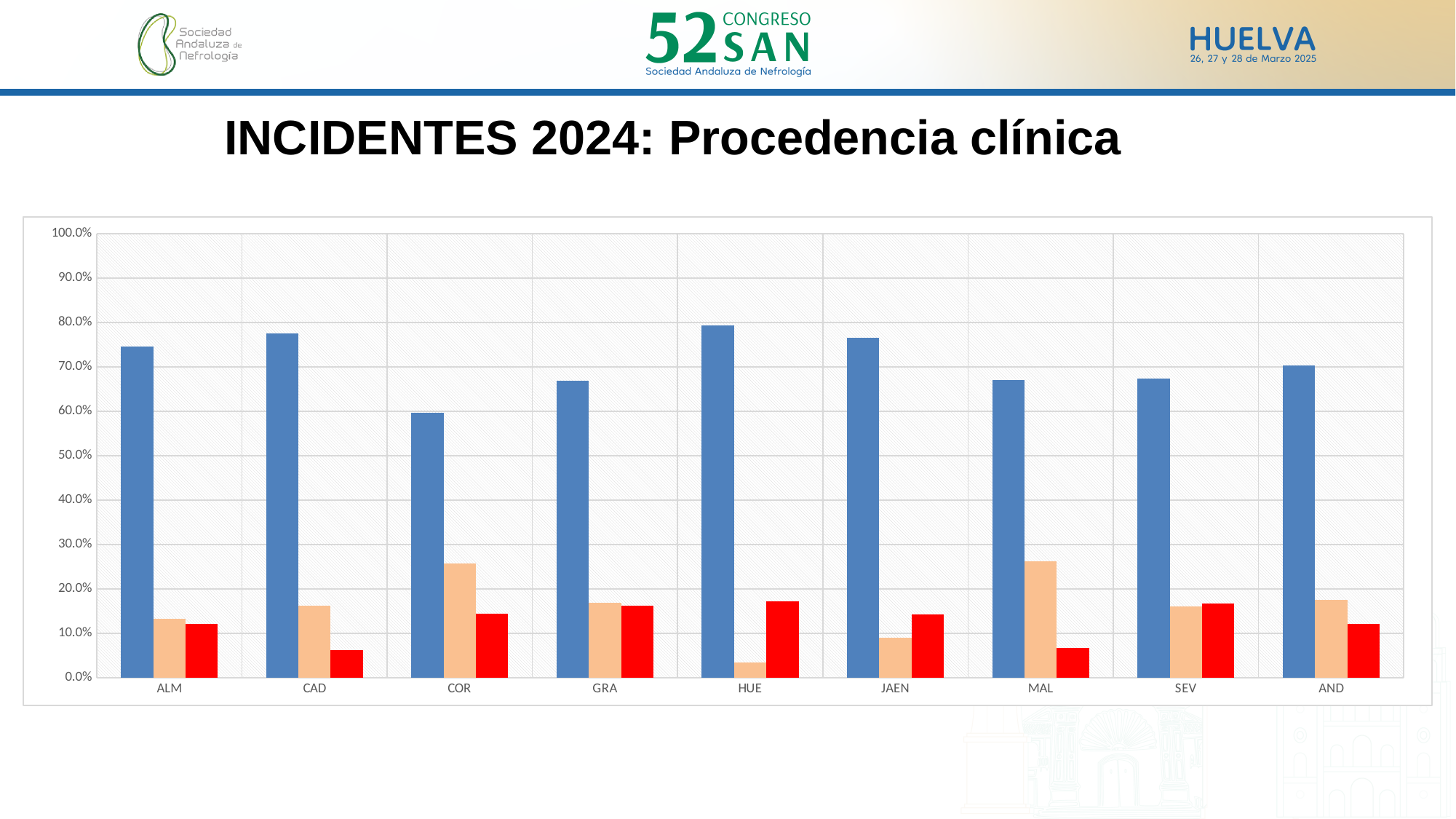
Which category has the tallest blue bar? HUE What is the title shown above the chart on the slide? INCIDENTES 2024: Procedencia clínica Is the red bar for CAD greater or less than 10.0%? less Which category has the shortest blue bar? COR Is the blue bar for HUE greater or less than 70.0%? greater What kind of chart is shown on the slide? bar chart Which is larger, the orange bar for COR or the orange bar for JAEN? COR Which is larger, the blue bar for ALM or the blue bar for COR? ALM Is the blue bar for COR greater or less than 70.0%? less How many categories are shown on the x axis of the chart? 9 Which category has the shortest orange bar? HUE